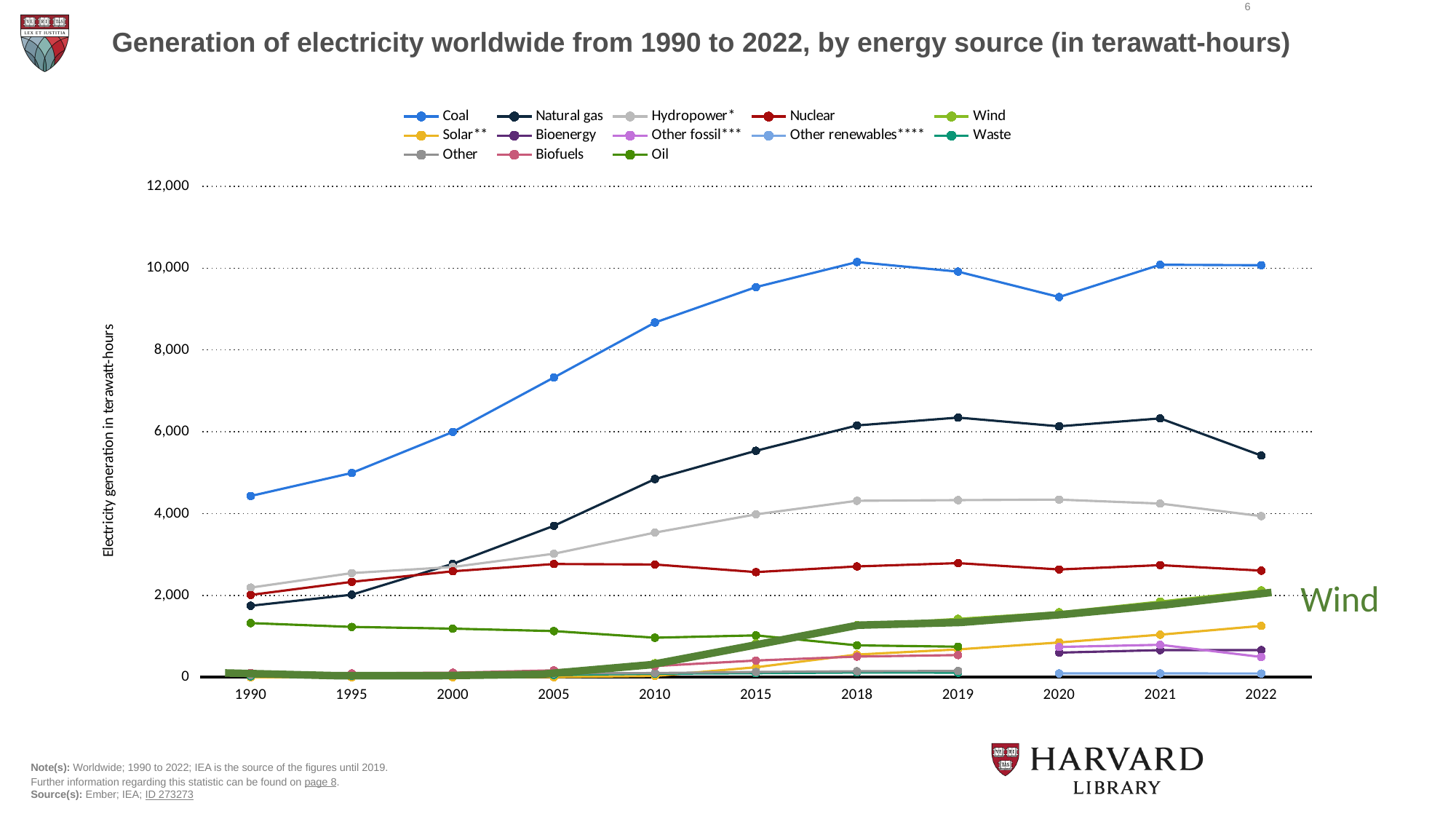
Which energy source has the highest electricity generation in 2022? Coal Is the value for Natural gas in 2010 greater or less than 4,000? greater Does the Coal line rise or fall from 1990 to 2018? rise What kind of chart is shown on the slide? line chart Is the value for Nuclear in 2022 greater or less than 2,000? greater Is the value for Coal in 2020 greater or less than 10,000? less Which is larger in 2022, Natural gas or Hydropower*? Natural gas How many energy sources does the legend list? 13 How many years are shown on the x axis? 11 Which series is highlighted with a thick green line and a large label on the right of the chart? Wind